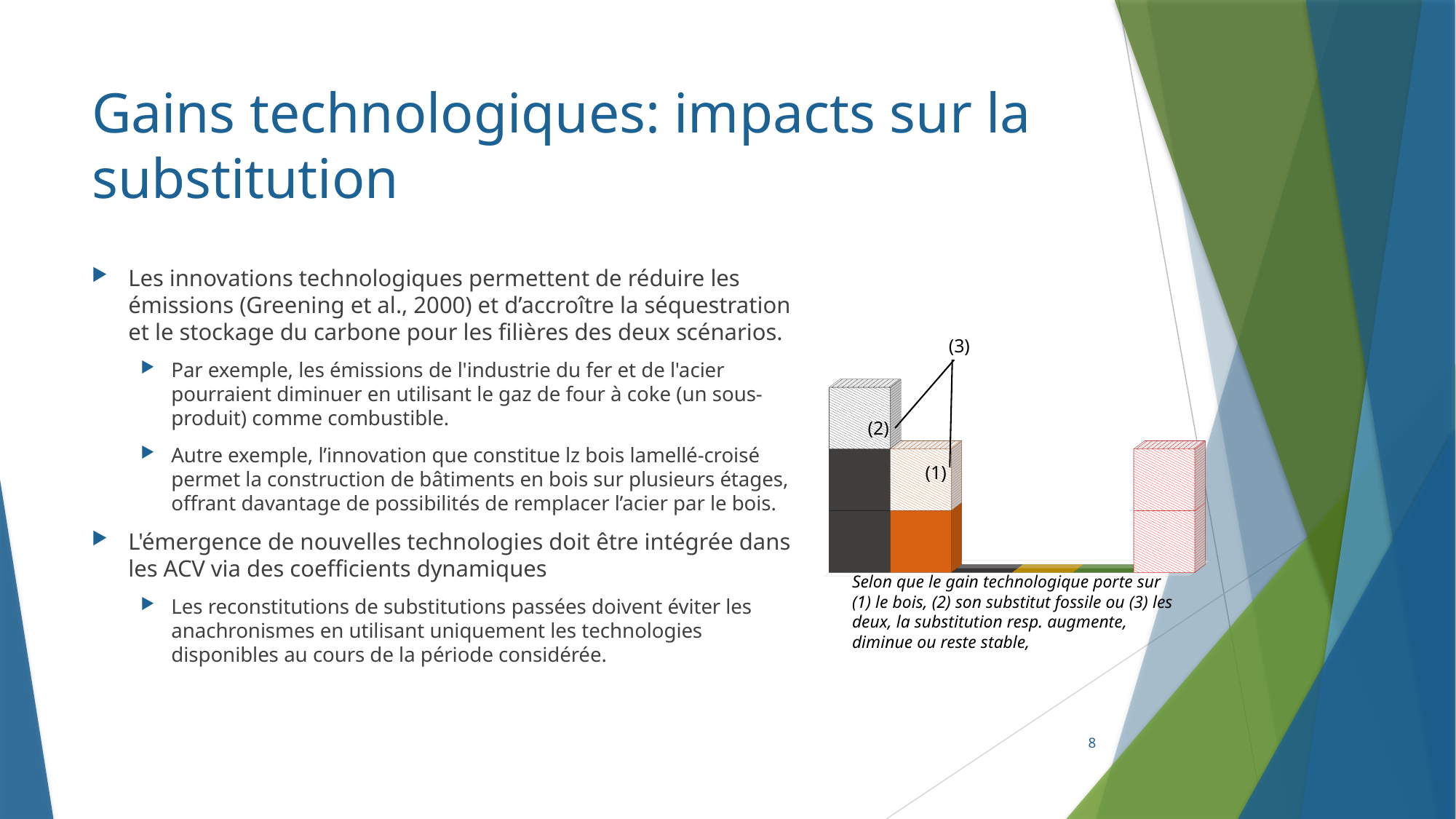
How many numbered annotations are placed on the chart? 3 Which is taller, the red hatched bar on the right or the orange bar? they are the same height Which numbered annotation is placed on the orange bar? (1) What colour is the leftmost bar in the chart? dark grey What kind of chart is shown on the right of the slide? bar chart Which is taller, the leftmost dark grey bar or the orange bar next to it? the dark grey bar Which bar in the chart is the tallest? the leftmost dark grey bar Of the three tall bars in the chart, which is the shortest? the orange bar and the red hatched bar are tied (equally short)